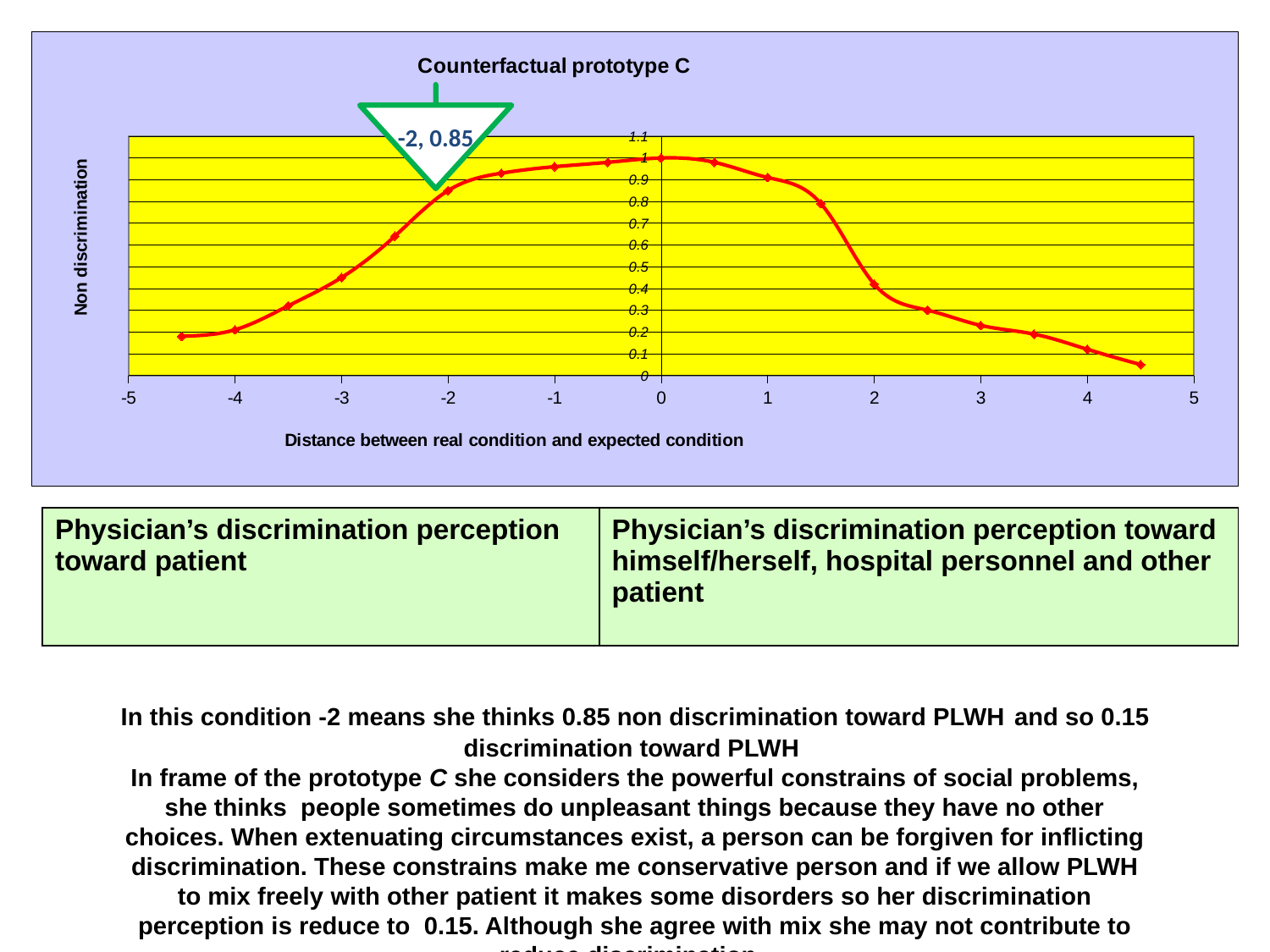
What is the title of the chart? Counterfactual prototype C At which x-axis value does the curve reach its highest point? 0 Do the values rise or fall as the distance goes from -5 toward 0? Rise Is the value at a distance of -4 greater or less than 0.3? less What is the label of the y axis of the chart? Non discrimination Is the value at a distance of 1 greater or less than 0.8? greater What kind of chart is shown on the slide? Line chart Which is larger, the value at a distance of -2 or the value at a distance of 3? -2 Is the value at a distance of 2 greater or less than 0.5? less According to the callout on the chart, what is the non discrimination value at a distance of -2? 0.85 Do the values rise or fall as the distance goes from 0 toward 5? Fall